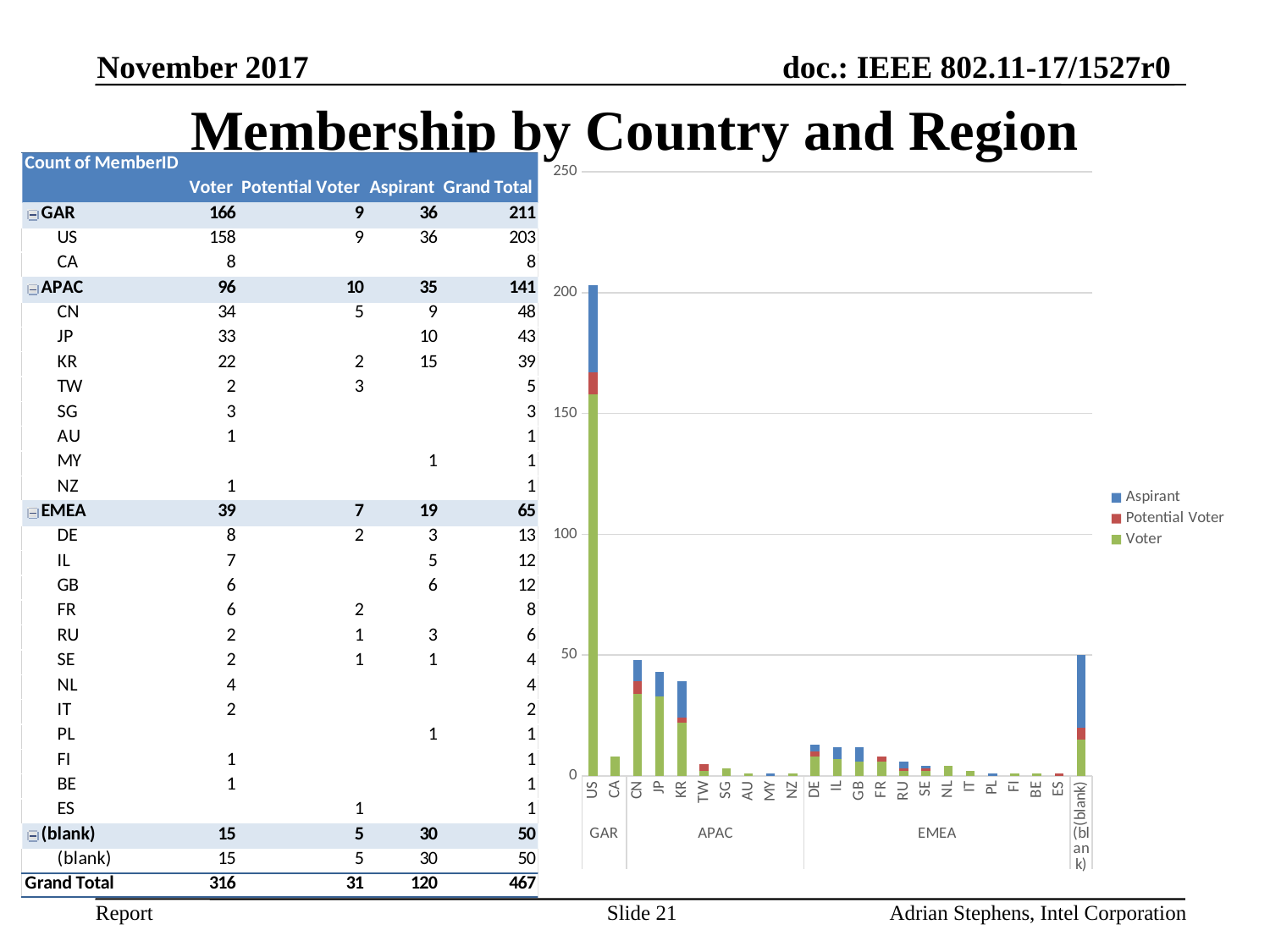
What is the total of the stacked bar for JP? 43 Which colour represents the Voter series in the chart legend? green Which bar is taller, CN or KR? CN How many country categories (including (blank)) are plotted along the x axis of the chart? 23 Is the total bar height for KR greater or less than 50? less Which country has the tallest bar in the chart? US What is the difference between the Grand Total for US and the Grand Total for CN? 155 What kind of chart is shown on the slide? stacked bar chart How many series does the chart legend list? 3 What is the Voter count for US shown in the table? 158 Is the total bar height for US greater or less than 150? greater What is the Grand Total for the APAC region? 141